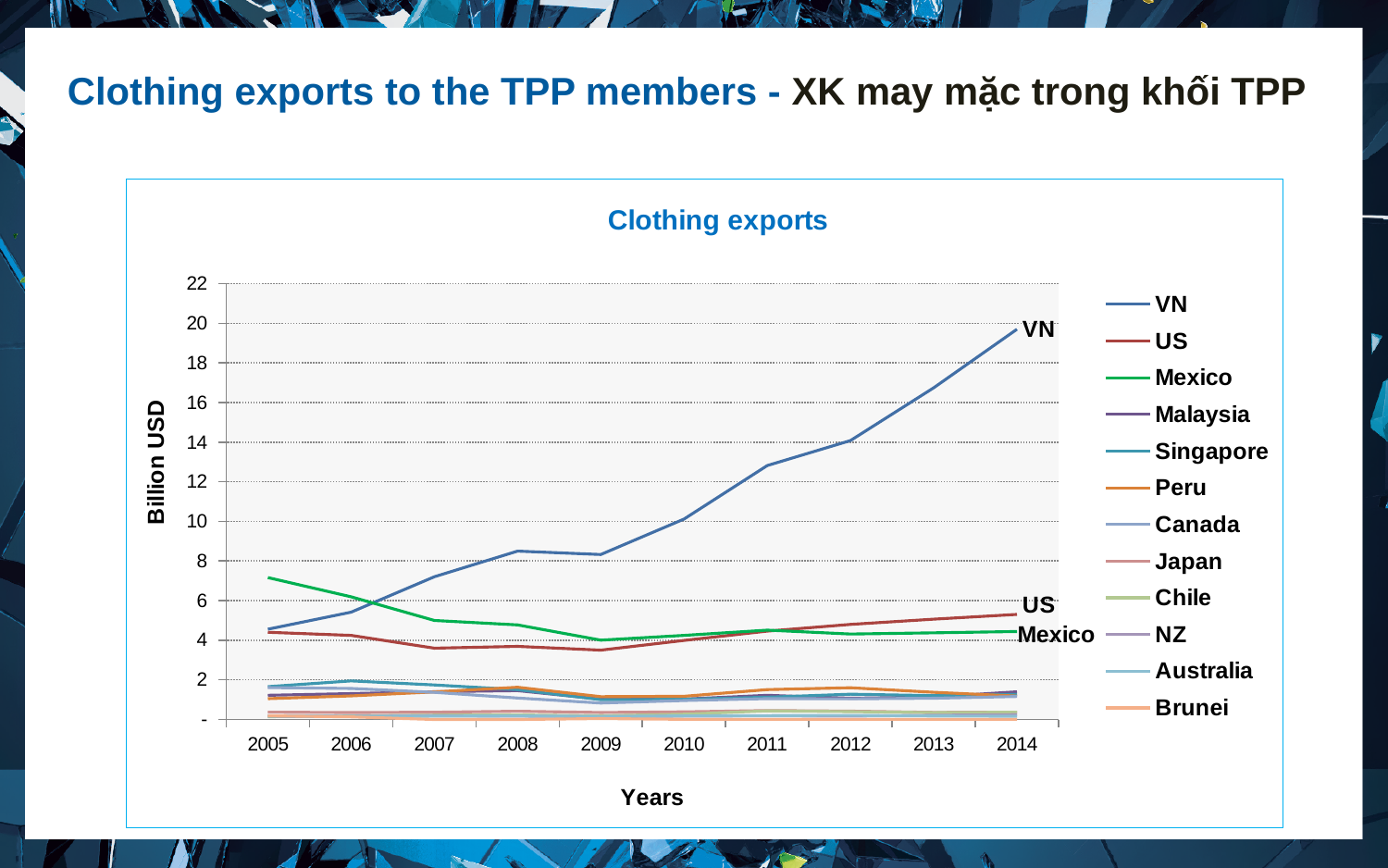
Which series has the highest value in 2014? VN Is the value for US in 2009 greater or less than 4? less Does the Mexico line rise or fall from 2005 to 2009? falls Is the value for Mexico in 2005 greater or less than 6? greater In 2014, which is larger: the value for US or the value for Mexico? US Does the VN line rise or fall from 2005 to 2014? rises Is the value for VN in 2014 greater or less than 18? greater How many years are shown on the x axis of the Clothing exports chart? 10 How many series does the legend of the Clothing exports chart list? 12 In 2005, which is larger: the value for Mexico or the value for VN? Mexico What kind of chart is shown on the slide? line chart What is the label of the y axis of the Clothing exports chart? Billion USD